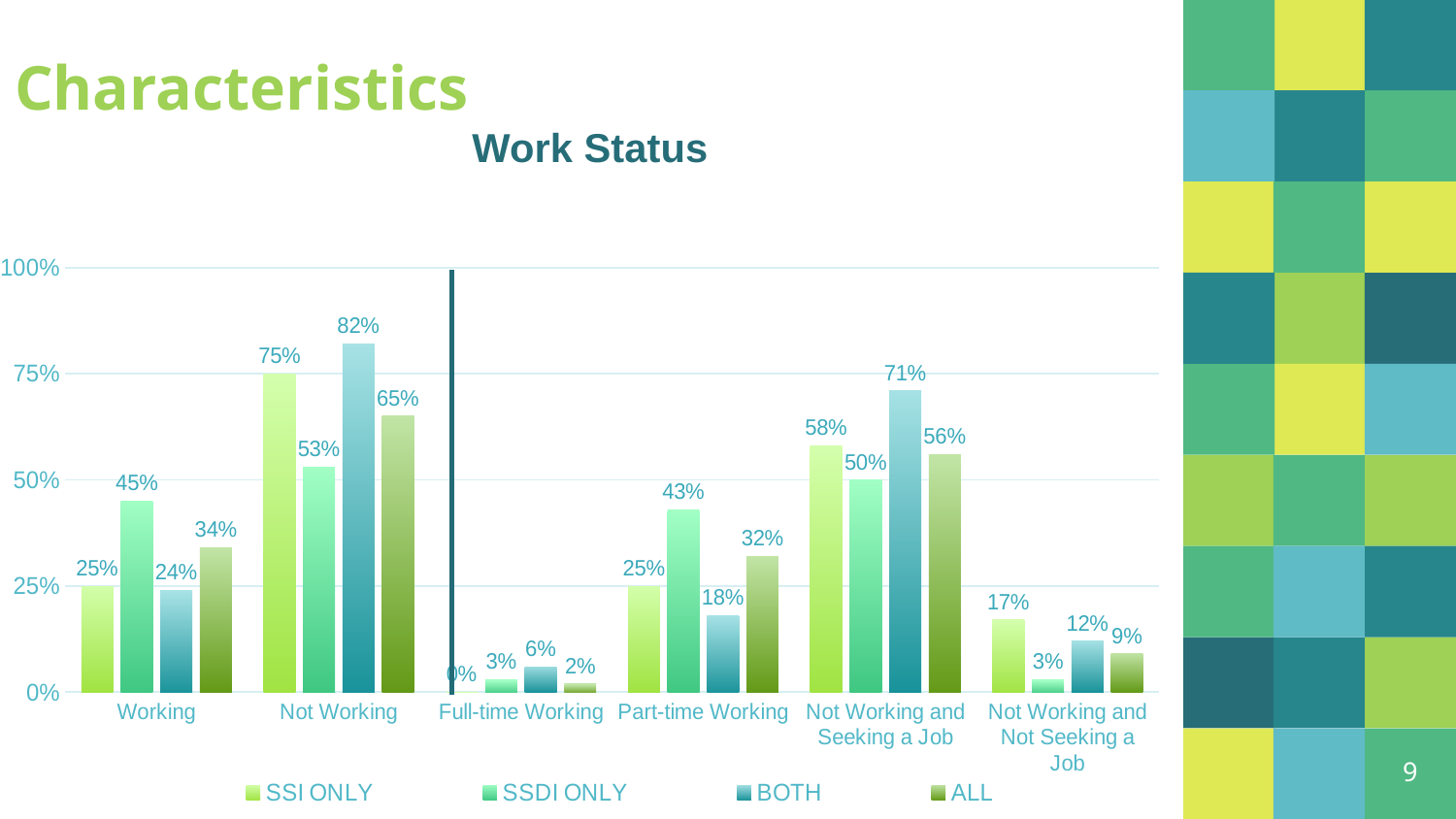
What kind of chart is shown on the slide? Bar chart What is the value for SSDI ONLY in the Working category? 45% What is the difference between the SSI ONLY and SSDI ONLY values in the Not Working category? 22% Which series has the lowest value in the Full-time Working category? SSI ONLY How many series does the legend list? 4 What is the value for ALL in the Part-time Working category? 32% Which is larger in the Part-time Working category: the SSDI ONLY value or the BOTH value? SSDI ONLY Which series has the highest value in the Not Working and Seeking a Job category? BOTH What is the value for BOTH in the Not Working category? 82% What is the title of the chart? Work Status What is the value for SSI ONLY in the Not Working and Not Seeking a Job category? 17% How many categories are shown on the x axis? 6